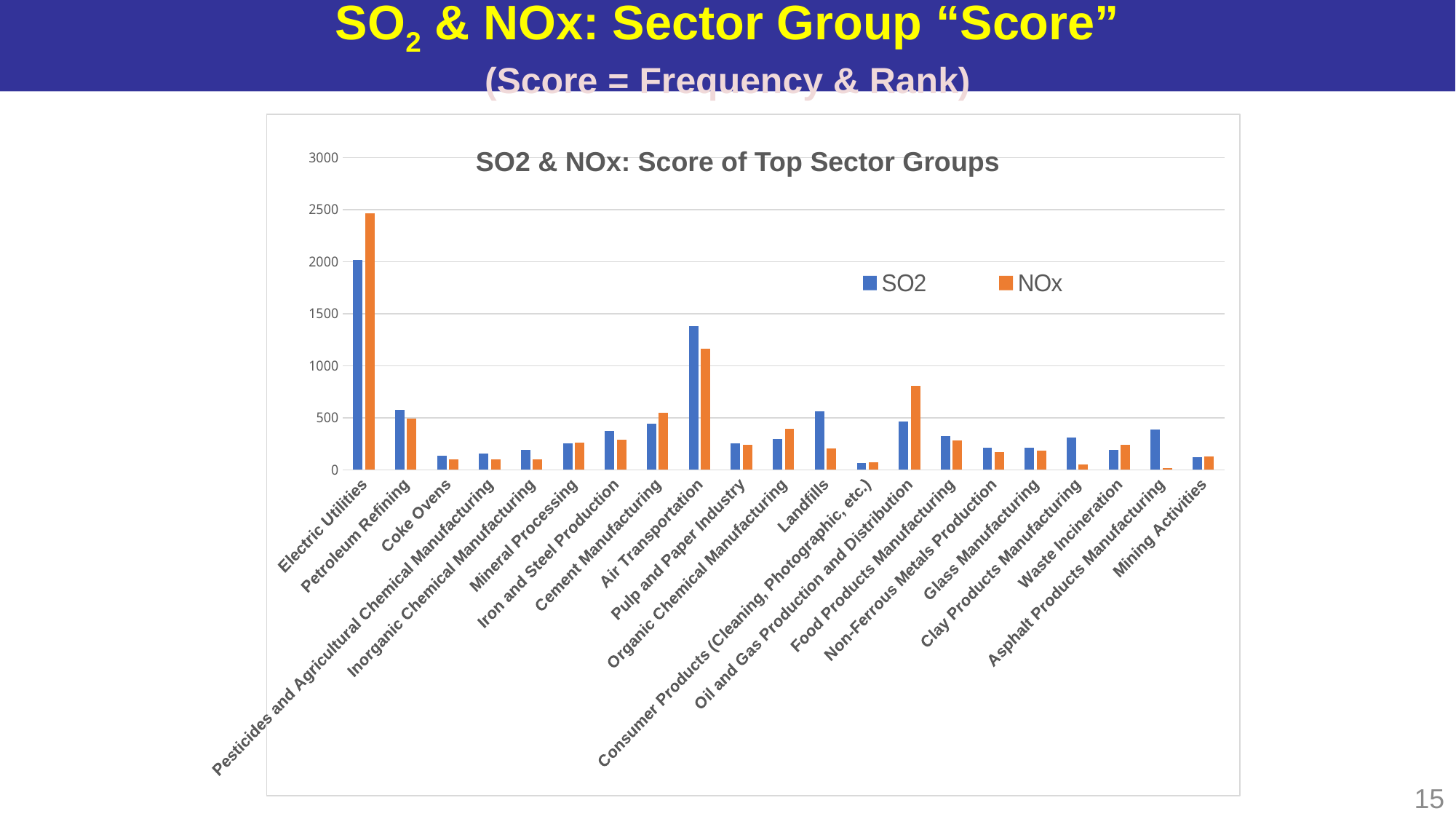
Is the NOx score for Electric Utilities greater or less than 2000? greater How many series does the legend list? 2 What type of chart is shown on the slide? bar chart Is the SO2 score for Air Transportation greater or less than 1500? less How many sector groups are shown on the x axis? 21 Which sector group has the highest SO2 score? Electric Utilities What is the title of the chart? SO2 & NOx: Score of Top Sector Groups Is the NOx score for Oil and Gas Production and Distribution greater or less than 500? greater Which sector group has the highest NOx score? Electric Utilities For Oil and Gas Production and Distribution, which is larger, the SO2 score or the NOx score? NOx Which sector group has the lowest NOx score? Asphalt Products Manufacturing For Air Transportation, which is larger, the SO2 score or the NOx score? SO2